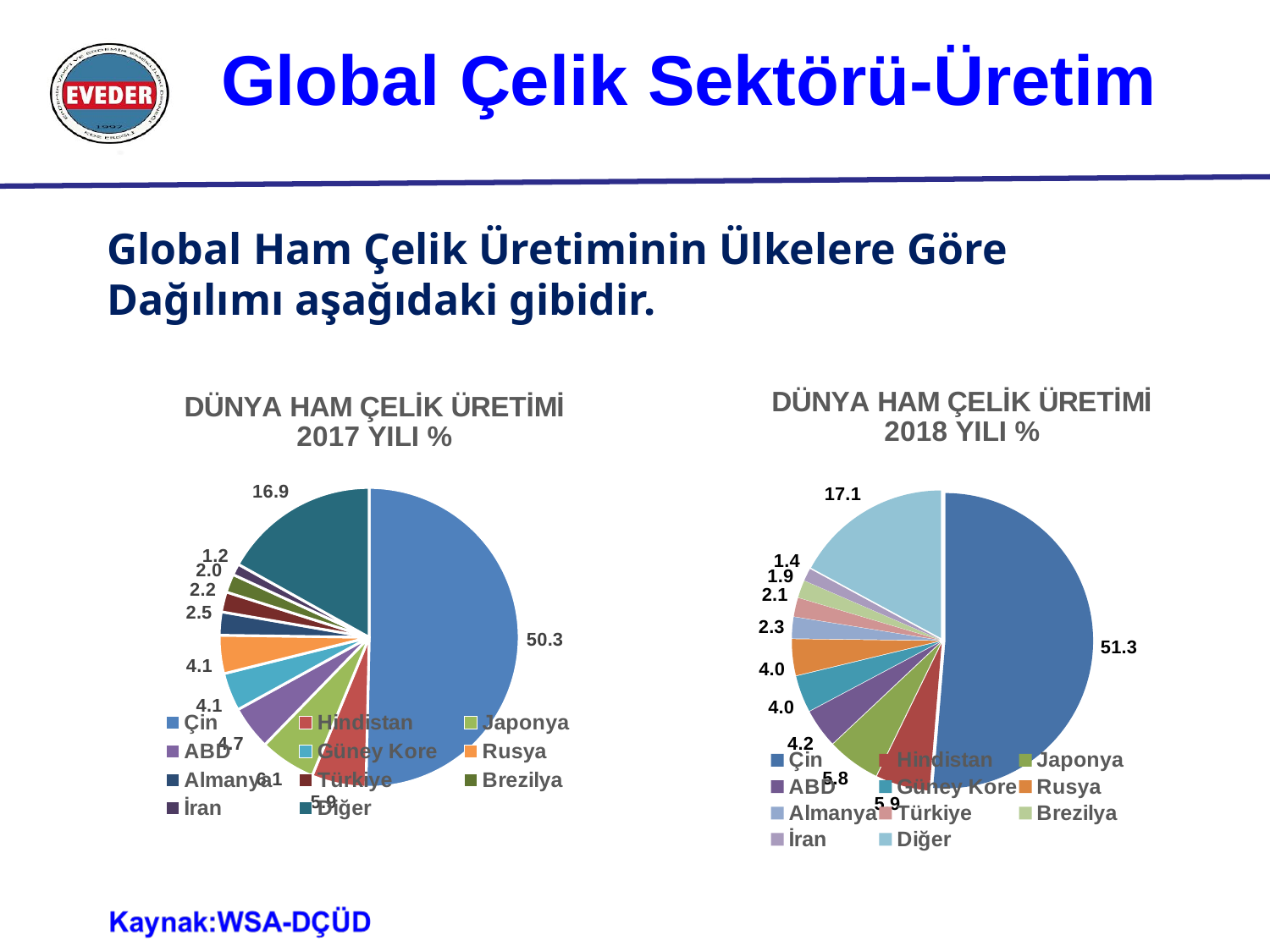
In the 2017 pie chart, what is the value shown for Almanya? 2.5 In the 2017 pie chart, which country has the smallest slice? İran In the 2018 pie chart, what is the value shown for İran? 1.4 In the 2017 pie chart, which country has the largest slice? Çin In the 2017 pie chart (DÜNYA HAM ÇELİK ÜRETİMİ 2017 YILI %), what is the value shown for Çin? 50.3 By how much is Çin's share in the 2018 pie chart higher than in the 2017 pie chart? 1.0 How many countries/categories does the legend of the 2017 pie chart list? 11 In the 2018 pie chart, what is the value shown for Diğer? 17.1 What type of chart is used for the 2018 DÜNYA HAM ÇELİK ÜRETİMİ data? Pie chart In the 2018 pie chart, which is larger, the slice for Almanya or the slice for Türkiye? Almanya In the 2018 pie chart, what is the value shown for Türkiye? 2.1 In the 2018 pie chart (DÜNYA HAM ÇELİK ÜRETİMİ 2018 YILI %), what is the value shown for Çin? 51.3